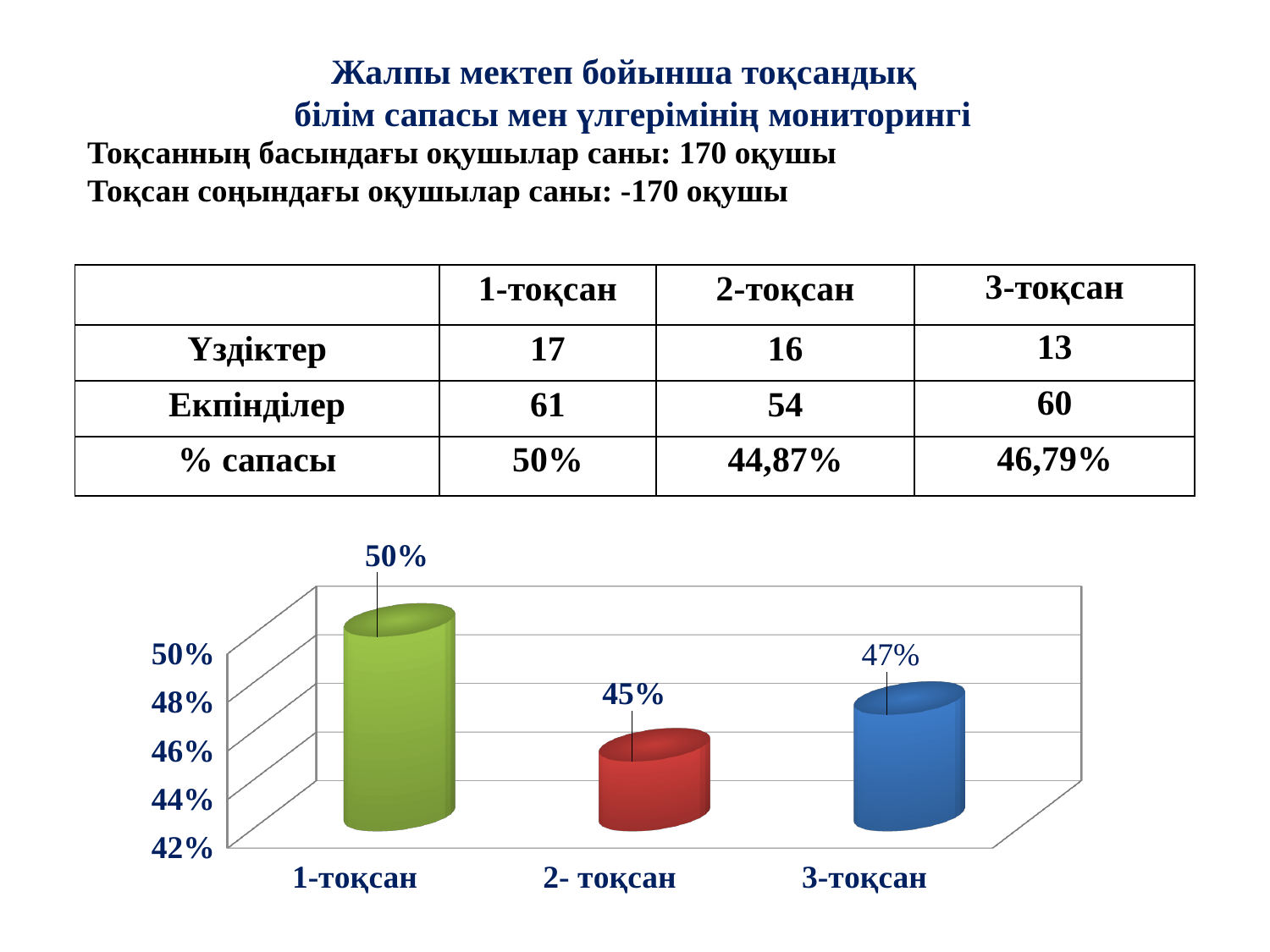
What kind of chart is shown on the slide? bar chart What colour is the bar for 2- тоқсан? red What value is shown for 3-тоқсан in the chart? 47% What is the difference between the values for 3-тоқсан and 2- тоқсан? 2% What value is shown for 2- тоқсан in the chart? 45% Is the value for 2- тоқсан greater or less than 46%? less How many categories are shown on the x axis of the chart? 3 Which is larger, the value for 3-тоқсан or the value for 2- тоқсан? 3-тоқсан Which category has the lowest value in the chart? 2- тоқсан Which category has the highest value in the chart? 1-тоқсан What value is shown for 1-тоқсан in the chart? 50% What is the difference between the values for 1-тоқсан and 2- тоқсан? 5%